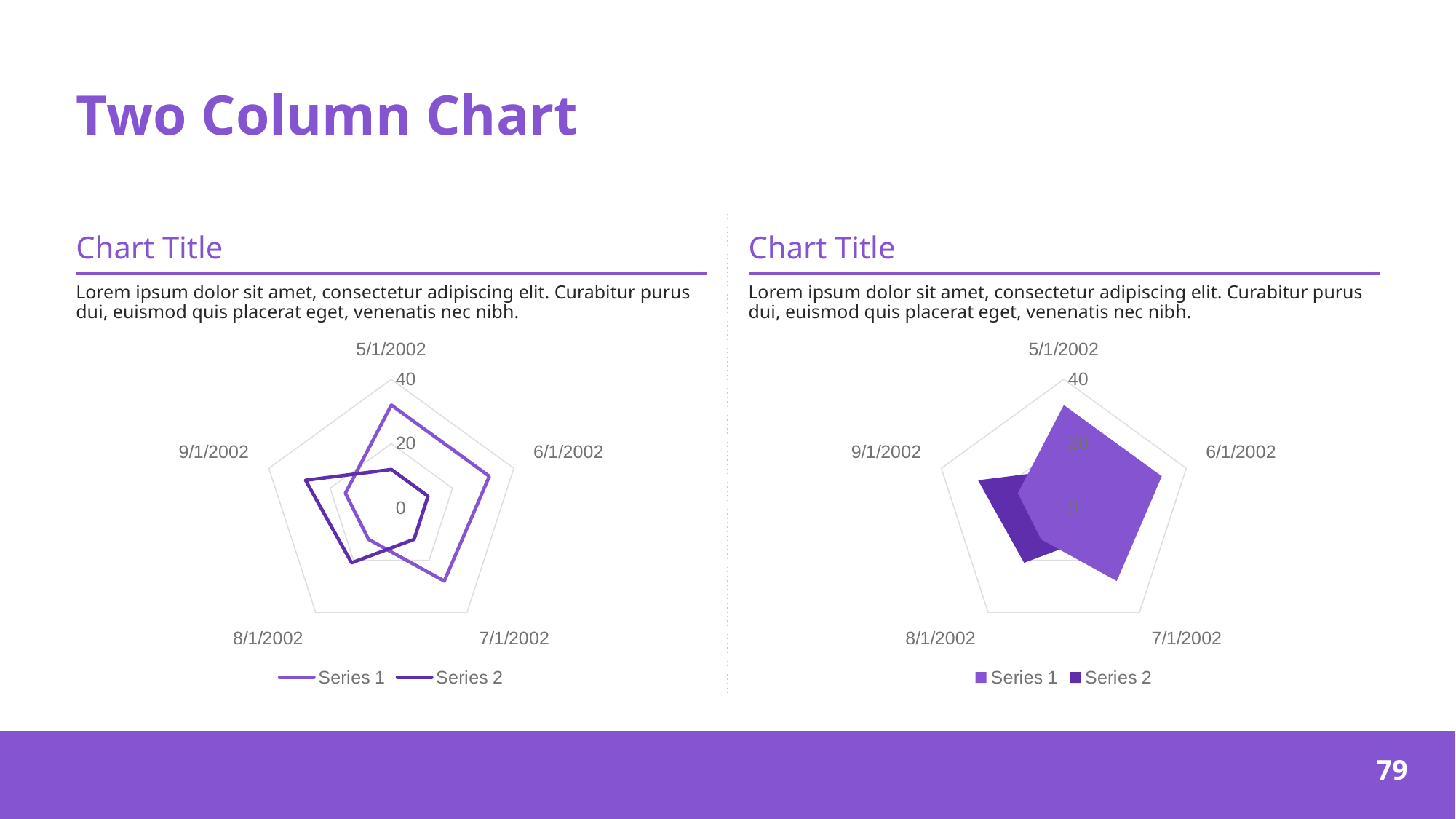
In the left chart, for which category is Series 1 lowest? 8/1/2002 In the left chart, which series has the larger value for 5/1/2002? Series 1 In the left chart, which series has the larger value for 8/1/2002? Series 2 In the left chart, is the value of Series 1 for 8/1/2002 greater or less than 20? less What kind of chart is the chart on the right side of the slide? filled radar chart In the right chart, is the value of Series 1 for 6/1/2002 greater or less than 20? greater In the right chart, how many categories are plotted around the radar? 5 In the left chart, is the value of Series 2 for 6/1/2002 greater or less than 20? less In the left chart, how many series does the legend list? 2 What is the highest value shown on the radial axis of the right chart? 40 What kind of chart is the chart on the left side of the slide? radar chart